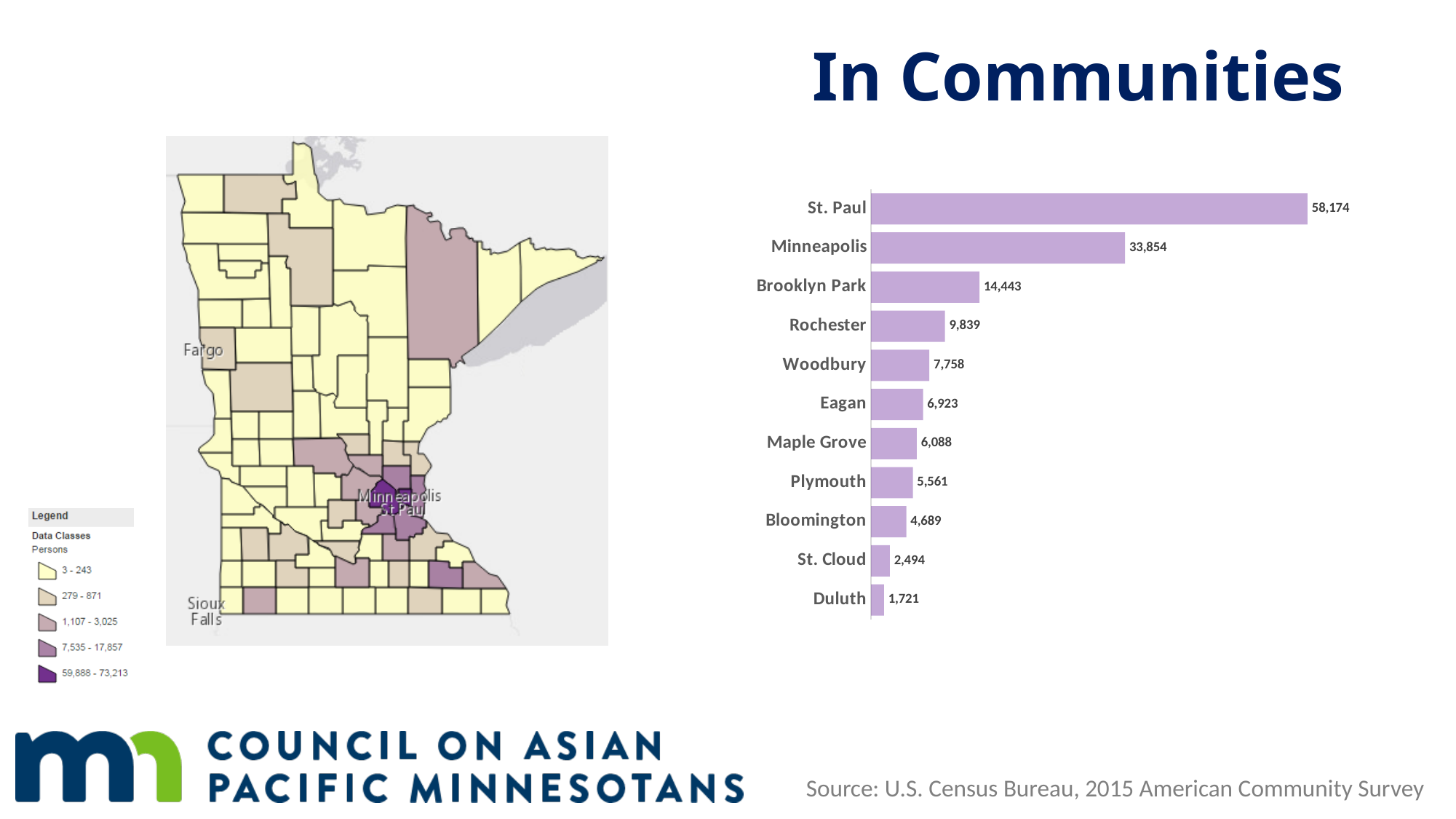
In the bar chart on the right, which has a larger value, Eagan or Maple Grove? Eagan What kind of chart is shown on the right side of the slide? Bar chart In the bar chart on the right, what is the value for Brooklyn Park? 14,443 In the bar chart on the right, what is the value for St. Paul? 58,174 In the map on the left, what range of persons does the darkest purple class represent? 59,888 - 73,213 In the bar chart on the right, how many communities are shown? 11 In the bar chart on the right, what is the difference between the values for Rochester and Woodbury? 2,081 In the bar chart on the right, what is the difference between the values for St. Paul and Minneapolis? 24,320 In the bar chart on the right, what is the value for Bloomington? 4,689 In the bar chart on the right, which community has the lowest value? Duluth In the bar chart on the right, which community has the highest value? St. Paul In the map on the left, how many data classes does the legend list? 5